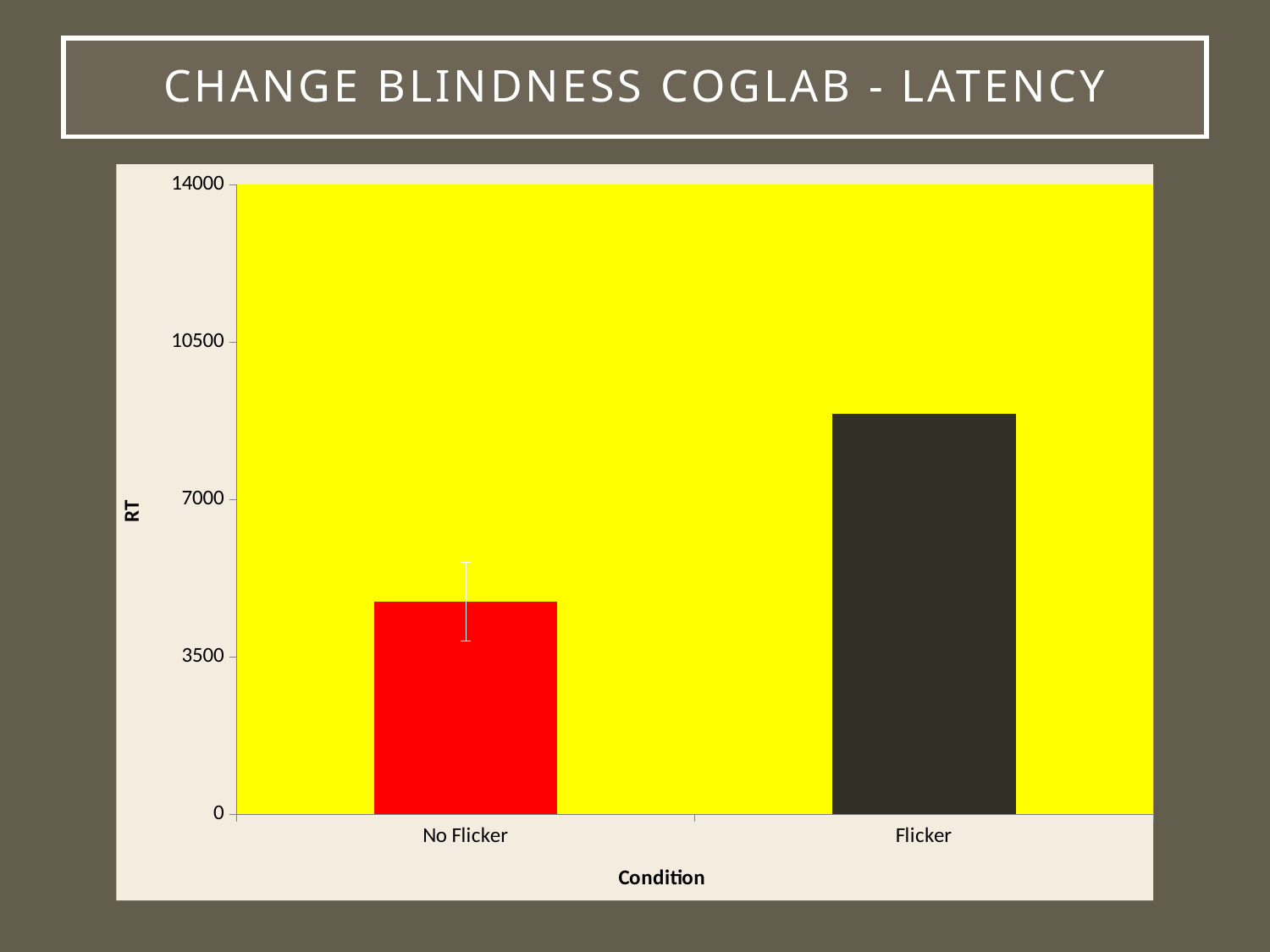
Which condition has the highest RT? Flicker Is the RT for Flicker greater or less than 10500? less Do the RT values rise or fall from No Flicker to Flicker along the x axis? rise What is the label on the y axis of the chart? RT Which has a larger RT, No Flicker or Flicker? Flicker Which condition has the lowest RT? No Flicker What colour is the bar for the No Flicker condition? red Is the RT for Flicker greater or less than 7000? greater Is the RT for No Flicker greater or less than 3500? greater How many conditions are plotted on the x axis? 2 What kind of chart is shown on the slide? bar chart